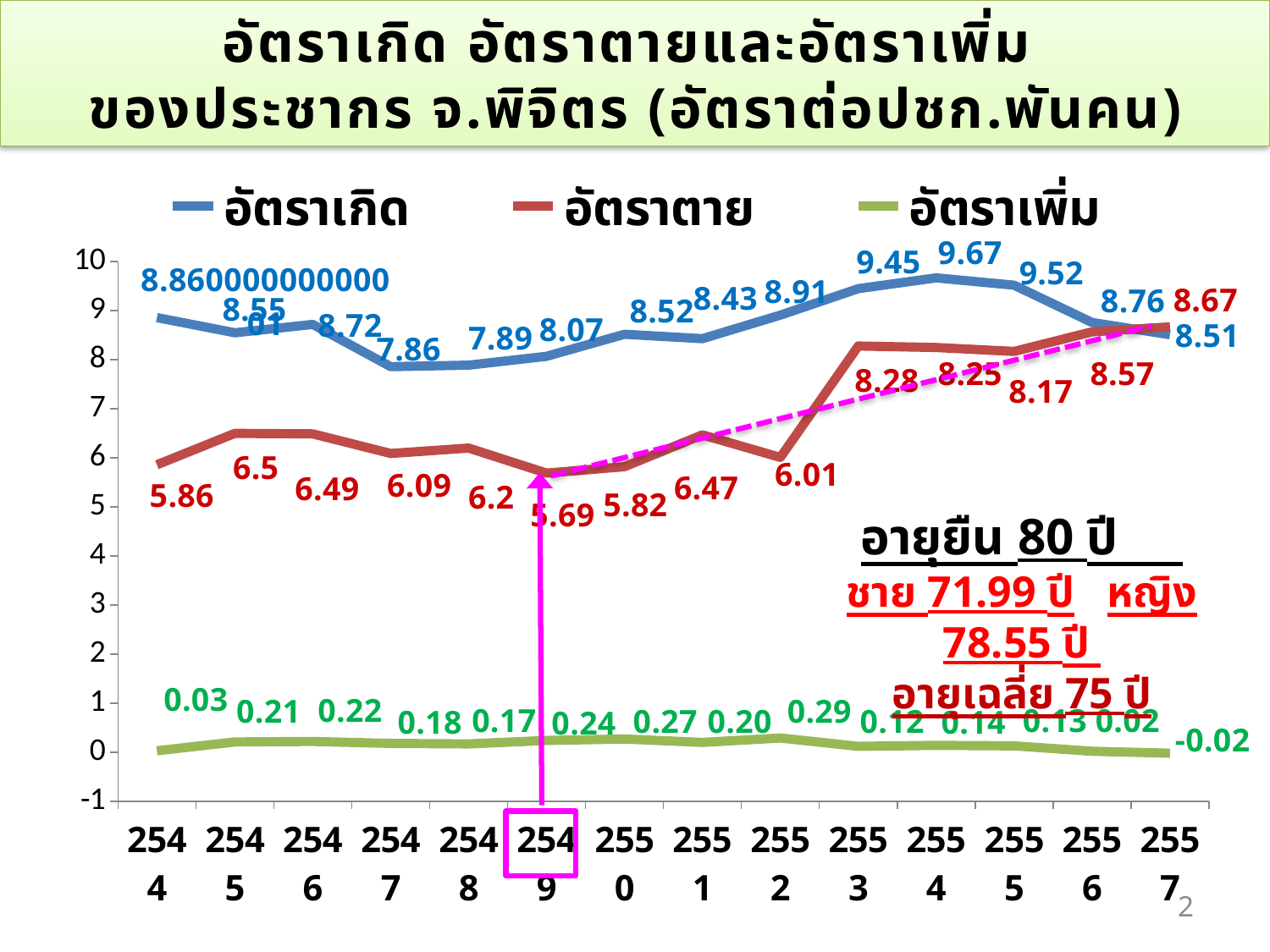
How many years are plotted along the x axis? 14 In 2557, which is larger: อัตราเกิด or อัตราตาย? อัตราตาย In which year is อัตราเพิ่ม (growth rate) highest? 2552 What kind of chart is shown on the slide? line chart What is the value of อัตราเกิด (birth rate) in 2554? 9.67 In which year is อัตราตาย (death rate) lowest? 2549 What is the value of อัตราตาย (death rate) in 2549? 5.69 What is the difference between อัตราตาย (8.67) and อัตราเกิด (8.51) in 2557? 0.16 In which year is อัตราเกิด (birth rate) highest? 2554 What is the value of อัตราเพิ่ม (growth rate) in 2557? -0.02 Does อัตราตาย (death rate) generally rise or fall from 2549 to 2557? rise How many series does the legend list? 3